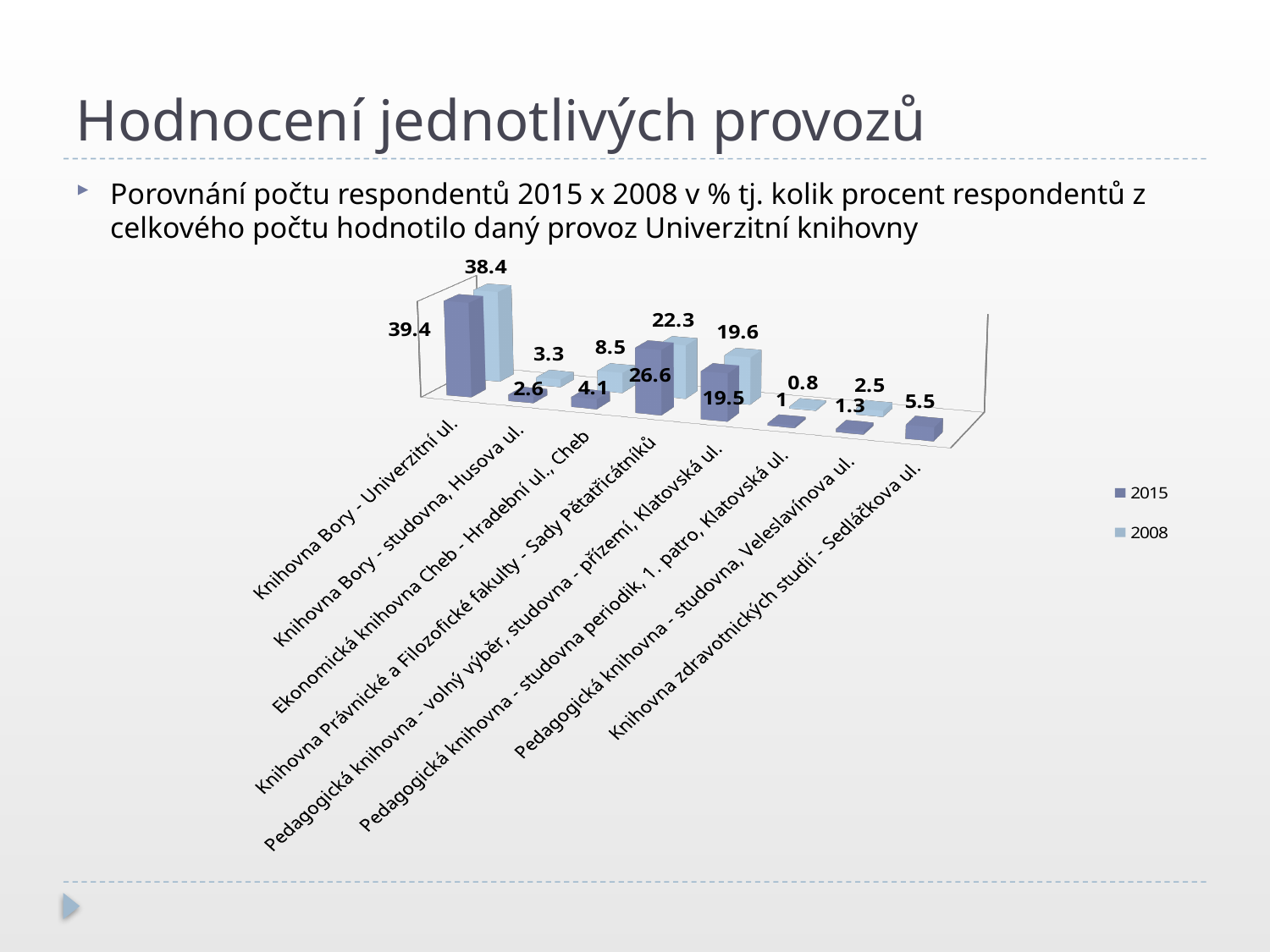
What is the difference between the 2015 and 2008 values for Knihovna Právnické a Filozofické fakulty - Sady Pětatřicátníků? 4.3 Which category has the lowest 2008 value? Pedagogická knihovna - studovna periodik, 1. patro, Klatovská ul. How many categories are shown on the x axis of the chart? 8 Which category has the highest 2015 value? Knihovna Bory - Univerzitní ul. What kind of chart is shown on the slide? Bar chart What is the 2008 value for Ekonomická knihovna Cheb - Hradební ul., Cheb? 8.5 What is the 2008 value for Pedagogická knihovna - studovna, Veleslavínova ul.? 2.5 Which series is shown in the darker blue colour in the chart? 2015 For Ekonomická knihovna Cheb - Hradební ul., Cheb, which year has the larger value, 2015 or 2008? 2008 What is the 2015 value for Knihovna Bory - Univerzitní ul.? 39.4 How many series does the chart legend list? 2 What is the 2015 value for Knihovna Právnické a Filozofické fakulty - Sady Pětatřicátníků? 26.6